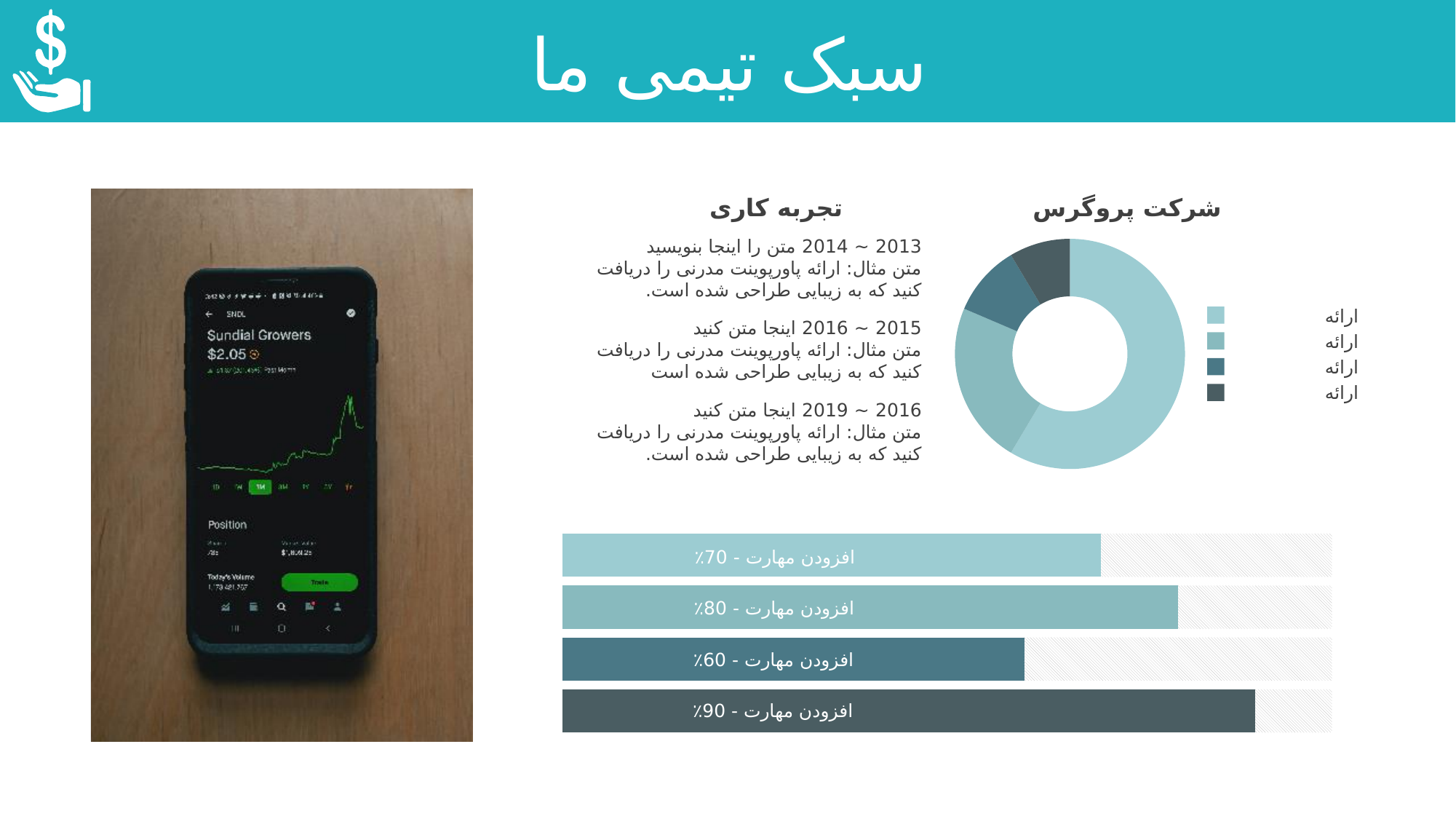
In the horizontal bars at the bottom right of the slide, what value is shown on the top bar? 70% What is the title of the doughnut chart on the slide? شرکت پروگرس In the horizontal bars at the bottom right of the slide, which bar has the lowest value? The third bar, 60% What type of chart is the chart titled "شرکت پروگرس"? Doughnut chart What label is used for every legend entry of the "شرکت پروگرس" chart? ارائه In the horizontal bars at the bottom right of the slide, what value is shown on the bottom bar? 90% How many entries does the legend of the "شرکت پروگرس" chart list? 4 In the horizontal bars at the bottom right of the slide, what is the difference between the highest and lowest values? 30% How many slices does the "شرکت پروگرس" doughnut chart have? 4 In the "شرکت پروگرس" chart, which colour slice is the largest? The lightest blue slice In the horizontal bars at the bottom right of the slide, which bar has the highest value? The bottom bar, 90% How many horizontal bars are shown at the bottom right of the slide? 4